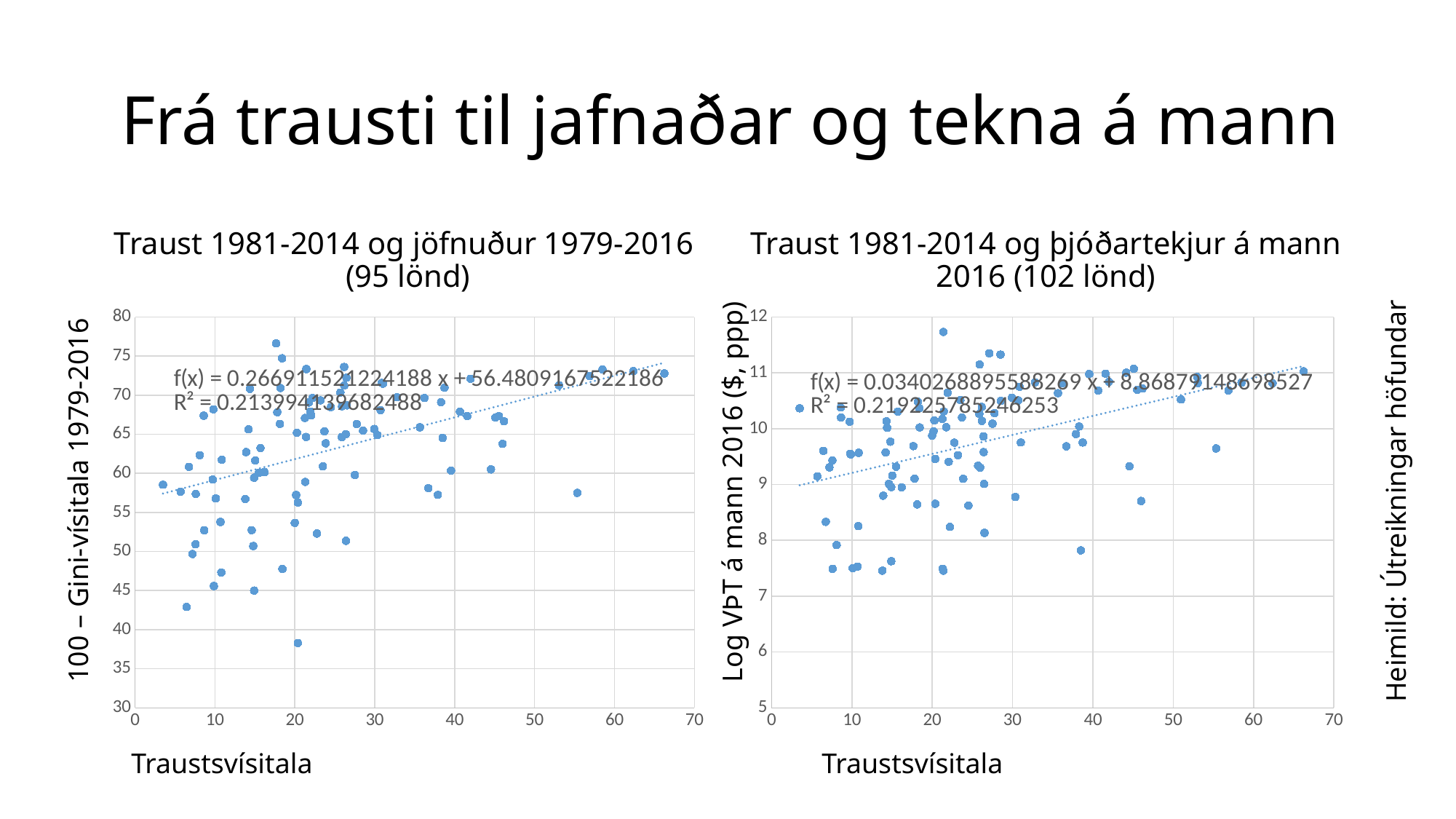
In the left chart, does the fitted trend line rise or fall as Traustsvísitala increases? Rises According to its title, how many countries are plotted in the right chart? 102 In the right chart, is the highest plotted point greater or less than 11 on the vertical axis? greater What kind of chart is the left chart, 'Traust 1981-2014 og jöfnuður 1979-2016 (95 lönd)'? Scatter chart What is the label of the vertical axis of the right chart? Log VÞT á mann 2016 ($, ppp) What is the R² value shown on the left chart? 0.213994139682488 What is the R² value shown on the right chart? 0.219225785246253 In the right chart, does the fitted trend line rise or fall as Traustsvísitala increases? Rises What is the slope of the fitted line f(x) shown on the right chart? 0.0340268895588269 In the left chart, is the lowest plotted point greater or less than 40 on the vertical axis? less According to its title, how many countries are plotted in the left chart? 95 What kind of chart is the right chart, 'Traust 1981-2014 og þjóðartekjur á mann 2016 (102 lönd)'? Scatter chart